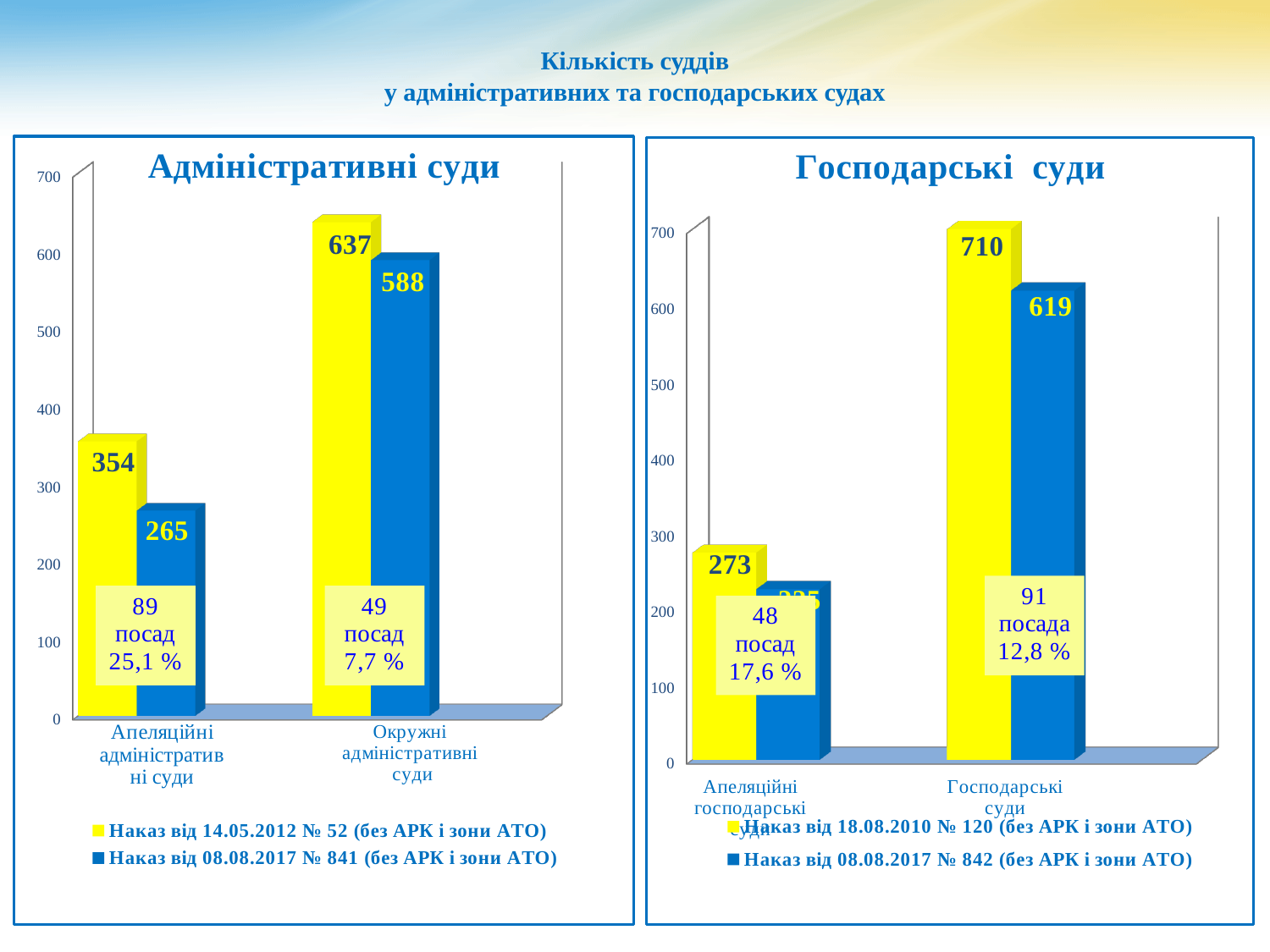
In the 'Господарські суди' chart, what is the value for 'Господарські суди' in the series 'Наказ від 08.08.2017 № 842 (без АРК і зони АТО)'? 619 In the 'Господарські суди' chart, what is the value for 'Апеляційні господарські суди' in the series 'Наказ від 18.08.2010 № 120 (без АРК і зони АТО)'? 273 In the 'Адміністративні суди' chart, what is the difference between the two values for 'Апеляційні адміністративні суди'? 89 In the 'Адміністративні суди' chart, which is larger for 'Окружні адміністративні суди': the 2012 order value or the 2017 order value? the 2012 order value (637) In the 'Господарські суди' chart, is the value for 'Господарські суди' in the series 'Наказ від 18.08.2010 № 120 (без АРК і зони АТО)' greater or less than 700? greater In the 'Адміністративні суди' chart, which category has the highest value in the series 'Наказ від 14.05.2012 № 52 (без АРК і зони АТО)'? Окружні адміністративні суди In the 'Адміністративні суди' chart, what is the value for 'Окружні адміністративні суди' in the series 'Наказ від 14.05.2012 № 52 (без АРК і зони АТО)'? 637 What kind of chart is the 'Адміністративні суди' chart? bar chart In the 'Господарські суди' chart, what is the difference between the two values for 'Господарські суди'? 91 In the 'Господарські суди' chart, which category has the lowest value in the series 'Наказ від 08.08.2017 № 842 (без АРК і зони АТО)'? Апеляційні господарські суди In the 'Адміністративні суди' chart, what is the value for 'Апеляційні адміністративні суди' in the series 'Наказ від 08.08.2017 № 841 (без АРК і зони АТО)'? 265 How many series does the legend of the 'Господарські суди' chart list? 2